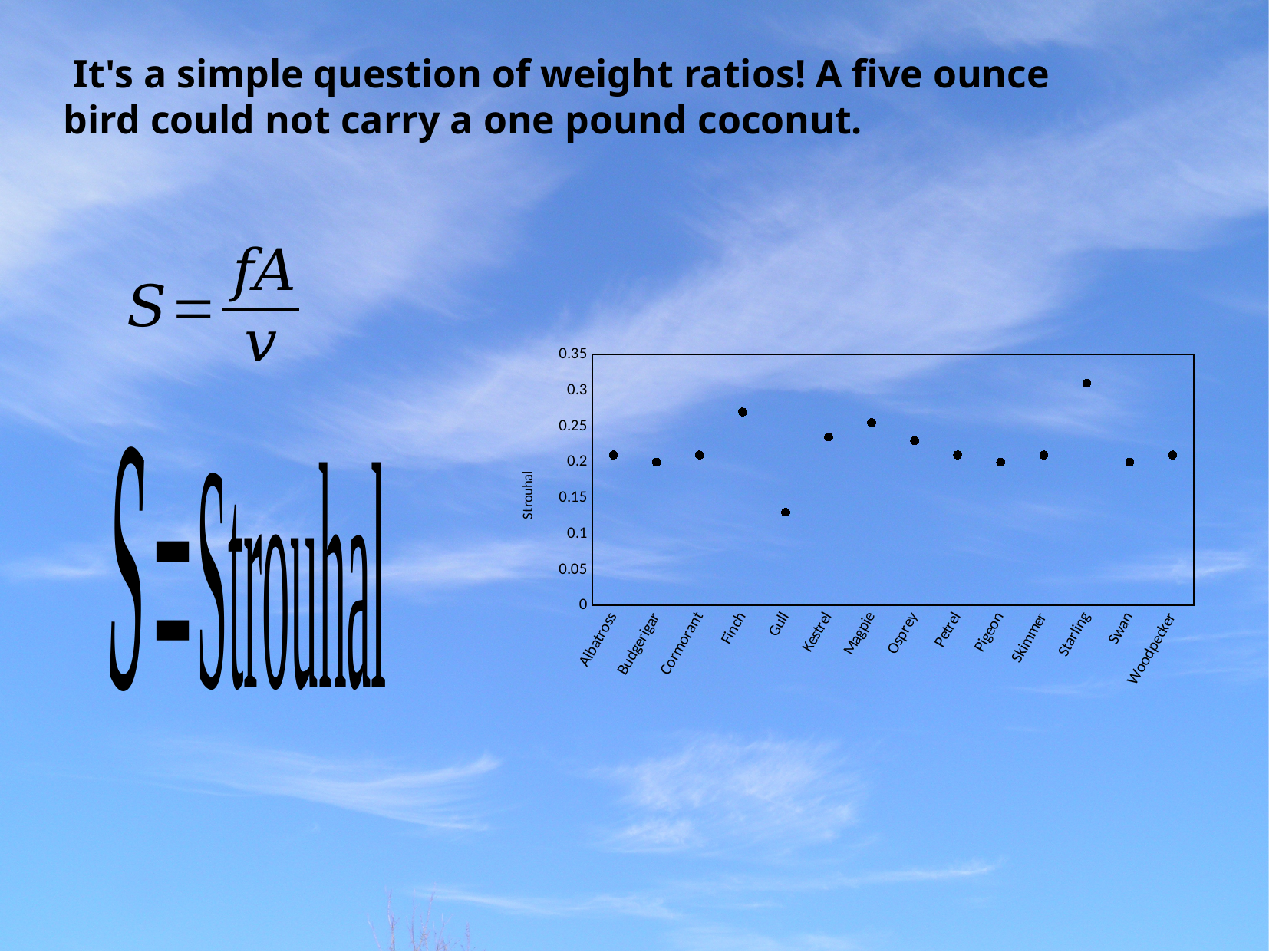
Which bird has the highest Strouhal value in the chart? Starling What kind of chart is shown on the slide? Scatter (dot) chart Which has the larger Strouhal value, Starling or Magpie? Starling What is the maximum value shown on the vertical axis of the chart? 0.35 Which has the larger Strouhal value, Finch or Gull? Finch Is the Strouhal value for Swan greater or less than 0.25? less Which bird has the lowest Strouhal value in the chart? Gull Is the Strouhal value for Gull greater or less than 0.15? less Is the Strouhal value for Starling greater or less than 0.3? greater How many birds are plotted along the x axis of the chart? 14 What is the label on the vertical axis of the chart? Strouhal